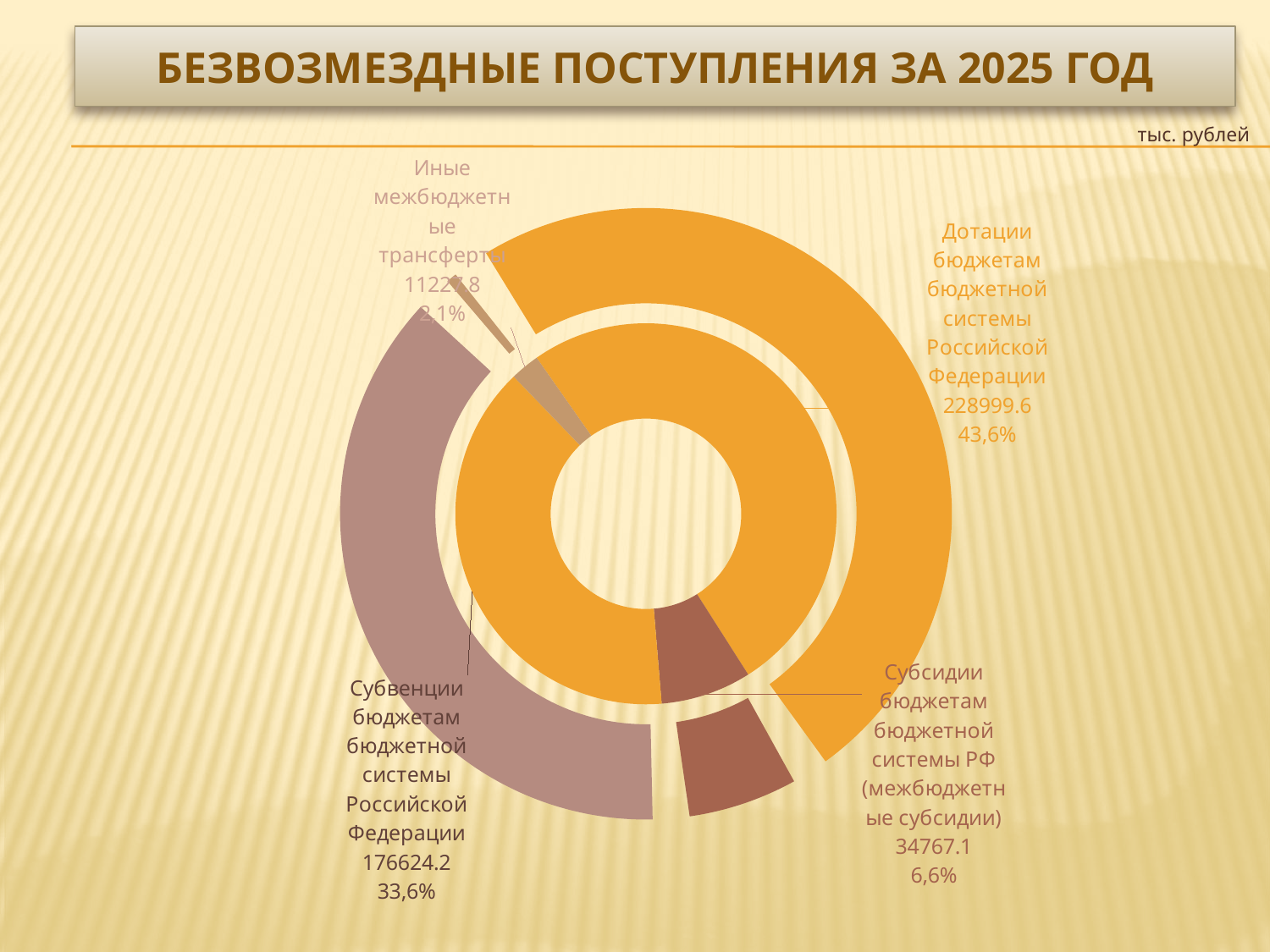
What share of the total do Иные межбюджетные трансферты represent? 2,1% What share of the total do Дотации бюджетам бюджетной системы Российской Федерации represent? 43,6% Which category has the smallest value? Иные межбюджетные трансферты What share of the total do Субвенции бюджетам бюджетной системы Российской Федерации represent? 33,6% What is the difference between the values for Дотации and Субвенции? 52375.4 Which category has the largest value? Дотации бюджетам бюджетной системы Российской Федерации What value is shown for Субсидии бюджетам бюджетной системы РФ (межбюджетные субсидии)? 34767.1 How many categories are shown in the chart? 4 What value is shown for Субвенции бюджетам бюджетной системы Российской Федерации? 176624.2 Which is larger: the value for Субвенции or the value for Субсидии? Субвенции What value is shown for Дотации бюджетам бюджетной системы Российской Федерации? 228999.6 What kind of chart is shown on the slide? Doughnut chart